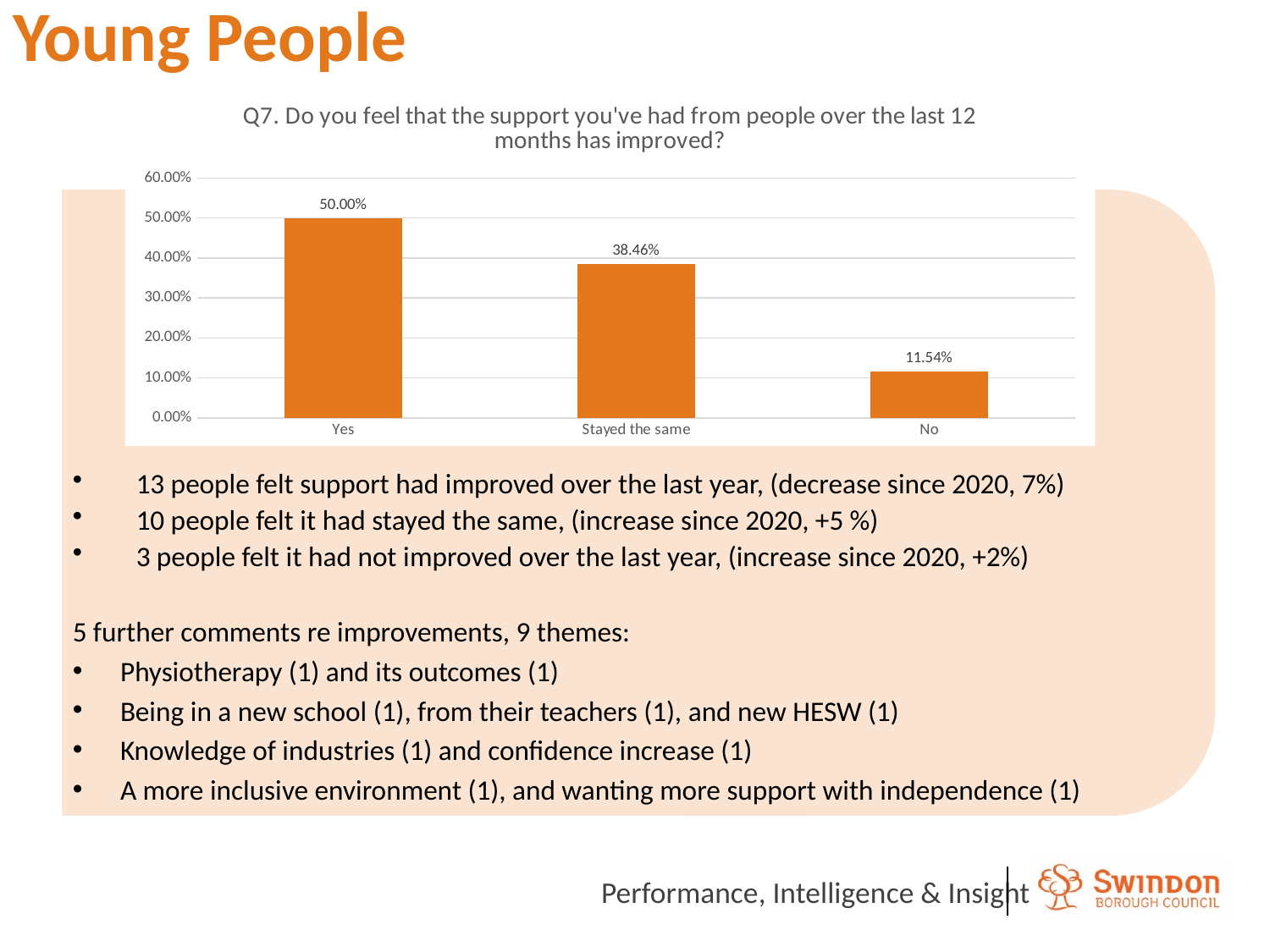
What is the value for "Yes"? 50.00% How many categories are shown on the x axis? 3 What is the value for "Stayed the same"? 38.46% What is the title of the chart? Q7. Do you feel that the support you've had from people over the last 12 months has improved? What is the value for "No"? 11.54% Which category has the lowest value? No Is the value for "Stayed the same" greater or less than 40.00%? less What is the difference between the values for "Stayed the same" and "No"? 26.92% Which is larger, the value for "Stayed the same" or the value for "No"? Stayed the same Which category has the highest value? Yes What kind of chart is shown on the slide? bar chart What is the difference between the values for "Yes" and "Stayed the same"? 11.54%